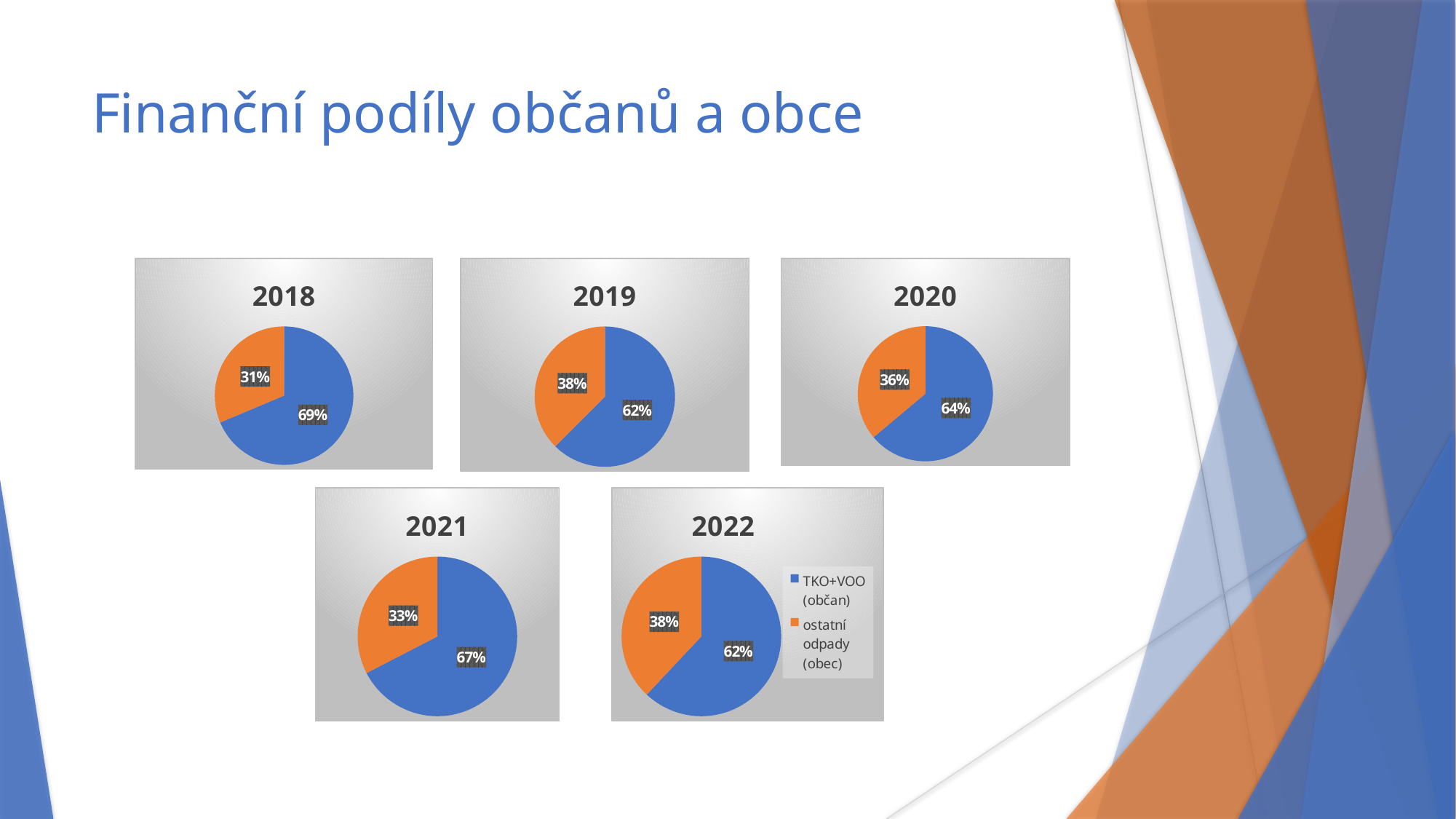
In the pie chart titled 2020, which slice is larger, the blue one or the orange one? the blue one How many entries does the legend next to the 2022 pie chart list? 2 What kind of chart is used for the year 2019 on this slide? pie chart How many slices does the pie chart titled 2022 have? 2 In the pie chart titled 2020, what share does the blue slice (TKO+VOO (občan)) have? 64% In the pie chart titled 2022, what share does the blue slice (TKO+VOO (občan)) have? 62% In the pie chart titled 2021, what is the difference between the blue slice and the orange slice? 34% In the pie chart titled 2021, what share does the orange slice (ostatní odpady (obec)) have? 33% How many pie charts are shown on the slide? 5